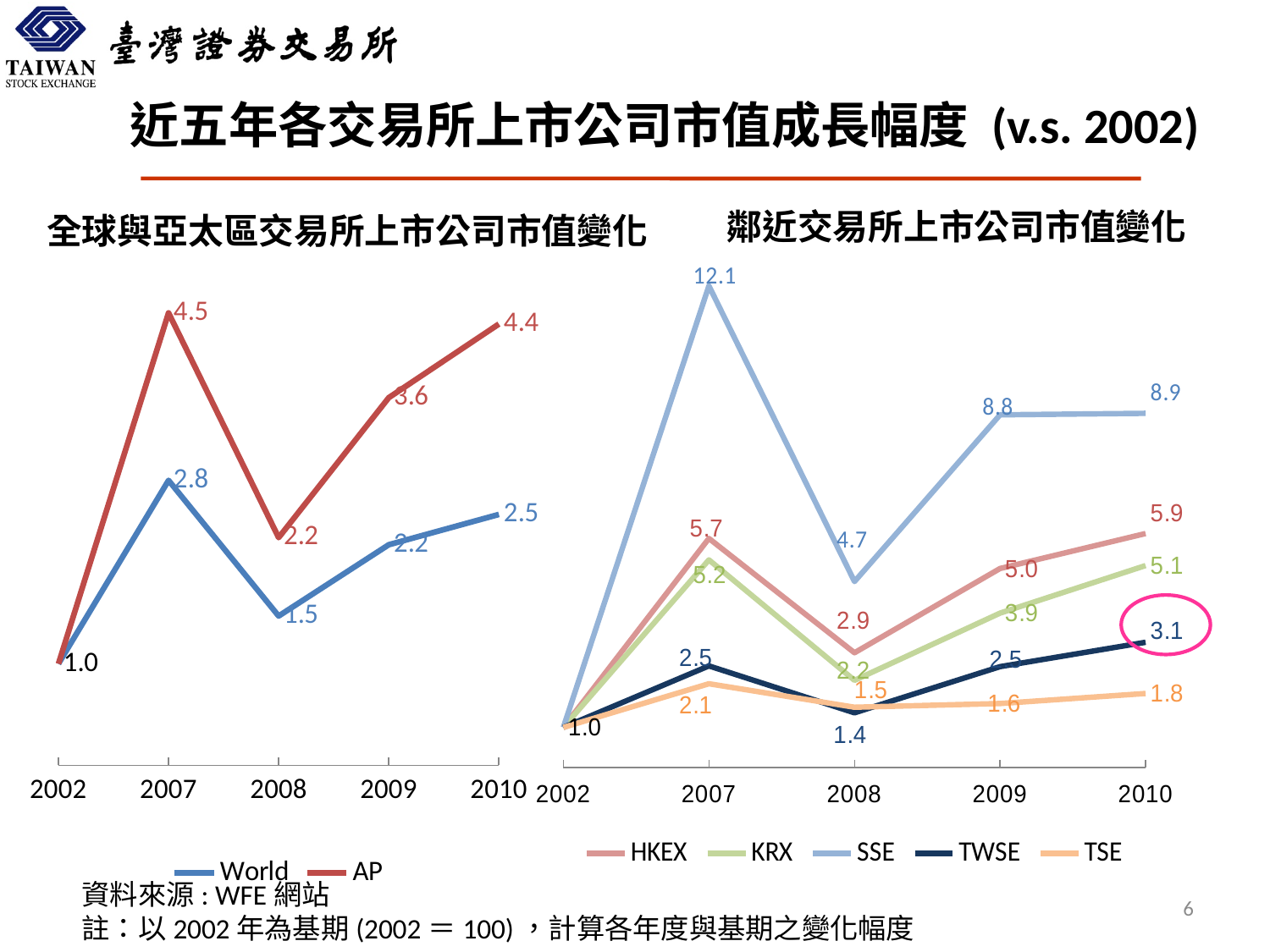
In the left chart, how many series does the legend list? 2 In the left chart, what is the difference between AP and World in 2010? 1.9 In the left chart, which series has the higher value in 2008, World or AP? AP In the right chart (鄰近交易所上市公司市值變化), what is the value for SSE in 2007? 12.1 In the right chart, how many series does the legend list? 5 What type of chart is the right chart? Line chart In the right chart, which series has the lowest value in 2010? TSE In the right chart, which series has the highest value in 2010? SSE In the right chart, what is the difference between HKEX and KRX in 2010? 0.8 In the left chart (全球與亞太區交易所上市公司市值變化), what is the value for AP in 2007? 4.5 In the left chart, what is the value for World in 2010? 2.5 In the right chart, what is the value for TWSE in 2010? 3.1